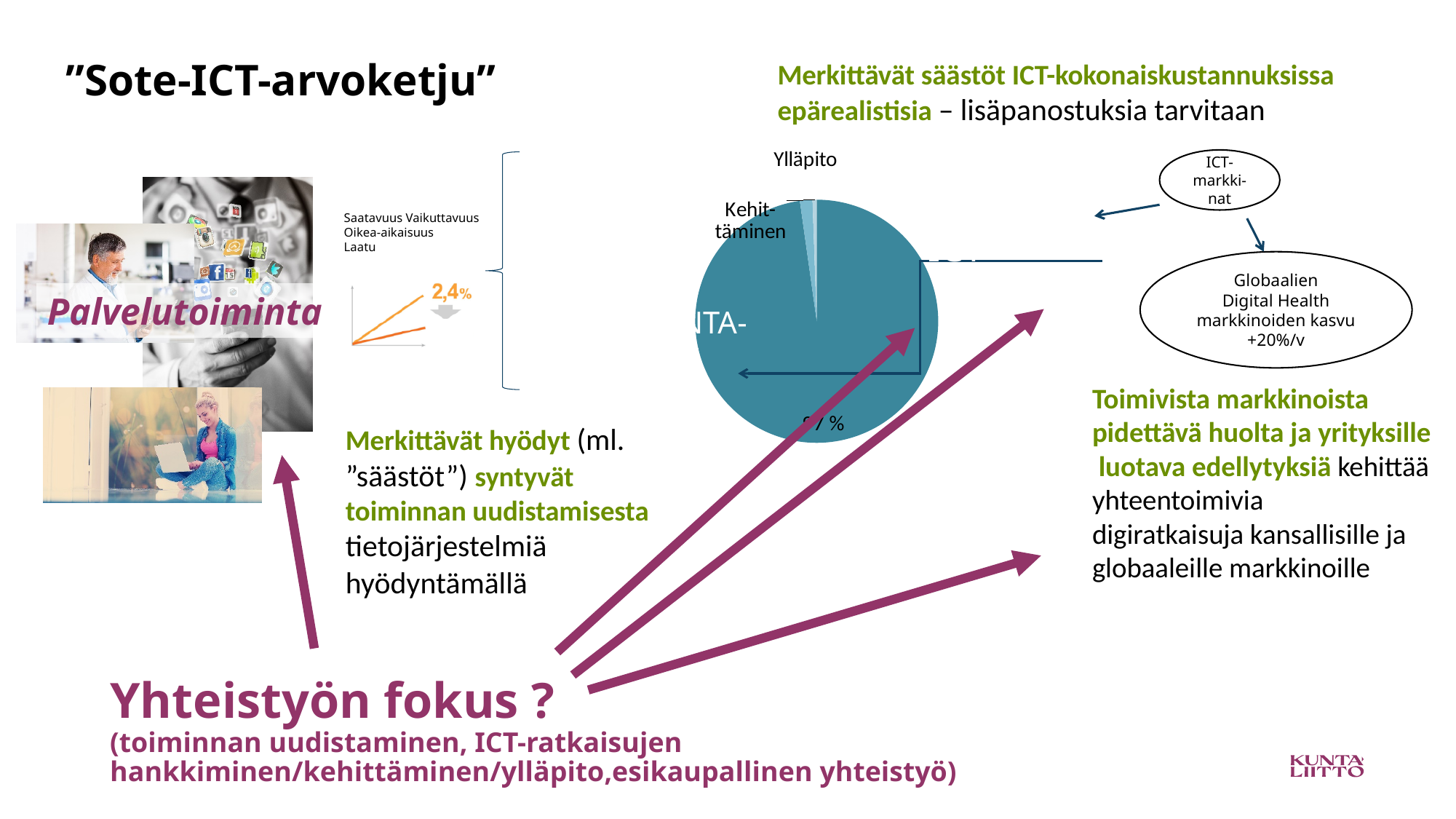
Which of the two small labelled slices of the pie chart is larger, Ylläpito or Kehittäminen? Ylläpito What colour is the largest slice of the pie chart? teal Is the share of the Kehittäminen slice in the pie chart greater or less than 10%? less Which label appears directly above the pie chart? Ylläpito Which of the two labelled slices, Ylläpito or Kehittäminen, is the smallest slice of the pie chart? Kehittäminen What kind of chart is shown in the middle of the slide, below the heading about ICT costs? pie chart How many slices does the pie chart have? 3 Is the share of the Ylläpito slice in the pie chart greater or less than 50%? less